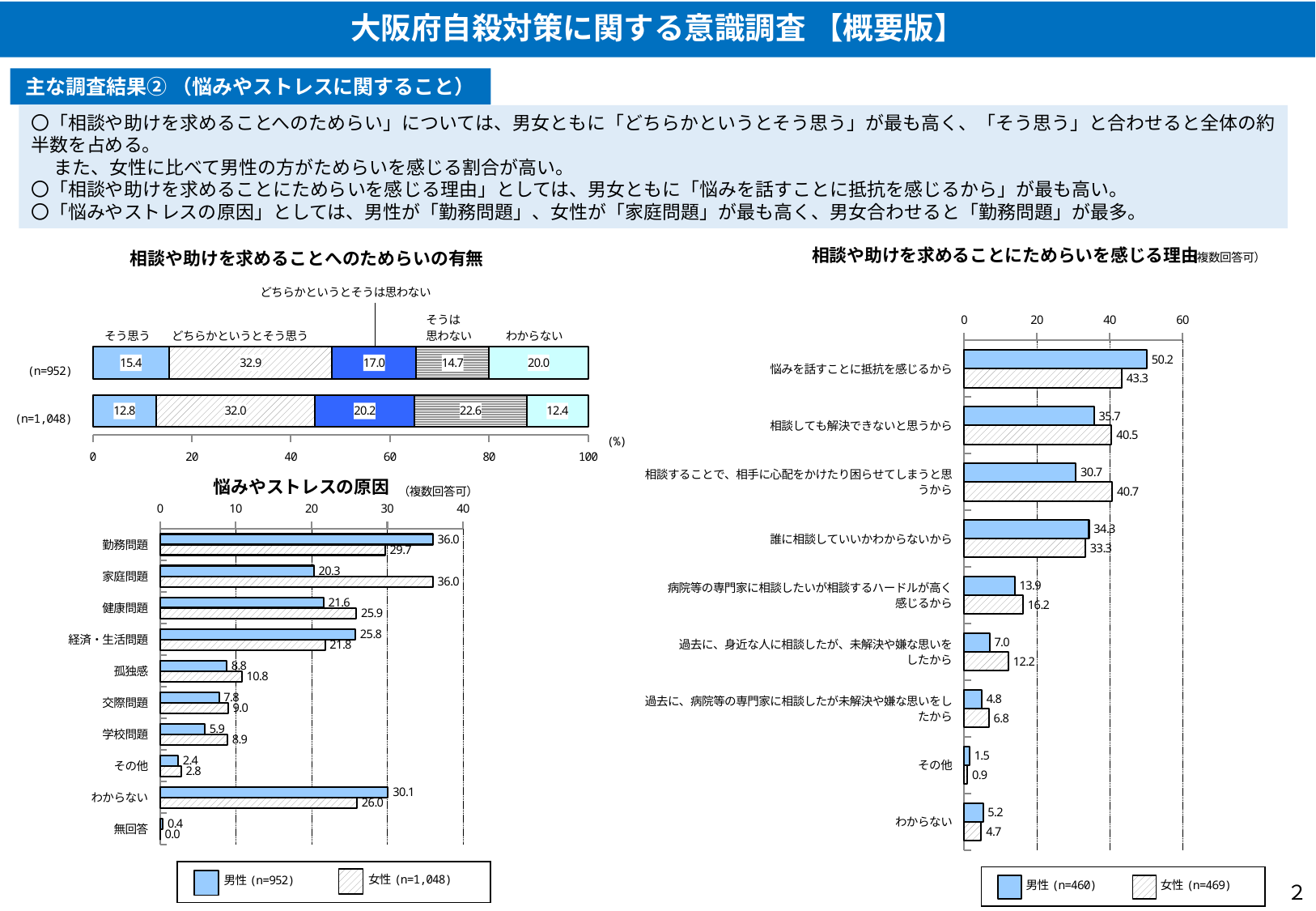
In the chart titled 「相談や助けを求めることにためらいを感じる理由」, what is the value for 男性 for 悩みを話すことに抵抗を感じるから? 50.2 In the chart titled 「悩みやストレスの原因」, what is the difference between the 男性 and 女性 values for 勤務問題? 6.3 What kind of chart is the chart titled 「相談や助けを求めることへのためらいの有無」? Stacked bar chart How many series does the legend list for the chart titled 「相談や助けを求めることにためらいを感じる理由」? 2 In the chart titled 「相談や助けを求めることへのためらいの有無」, what is the combined value of そう思う and どちらかというとそう思う for the (n=1,048) bar? 44.8 In the chart titled 「相談や助けを求めることにためらいを感じる理由」, which category has the highest value for 女性? 悩みを話すことに抵抗を感じるから In the chart titled 「相談や助けを求めることへのためらいの有無」, what is the value of どちらかというとそう思う for the (n=952) bar? 32.9 In the chart titled 「悩みやストレスの原因」, what is the value for 女性 for 家庭問題? 36.0 How many categories are shown in the chart titled 「悩みやストレスの原因」? 10 In the chart titled 「相談や助けを求めることにためらいを感じる理由」, which is larger for 相談することで、相手に心配をかけたり困らせてしまうと思うから: the 男性 value or the 女性 value? 女性 In the chart titled 「相談や助けを求めることにためらいを感じる理由」, which category has the lowest value for 女性? その他 In the chart titled 「悩みやストレスの原因」, what is the value for 男性 for 勤務問題? 36.0